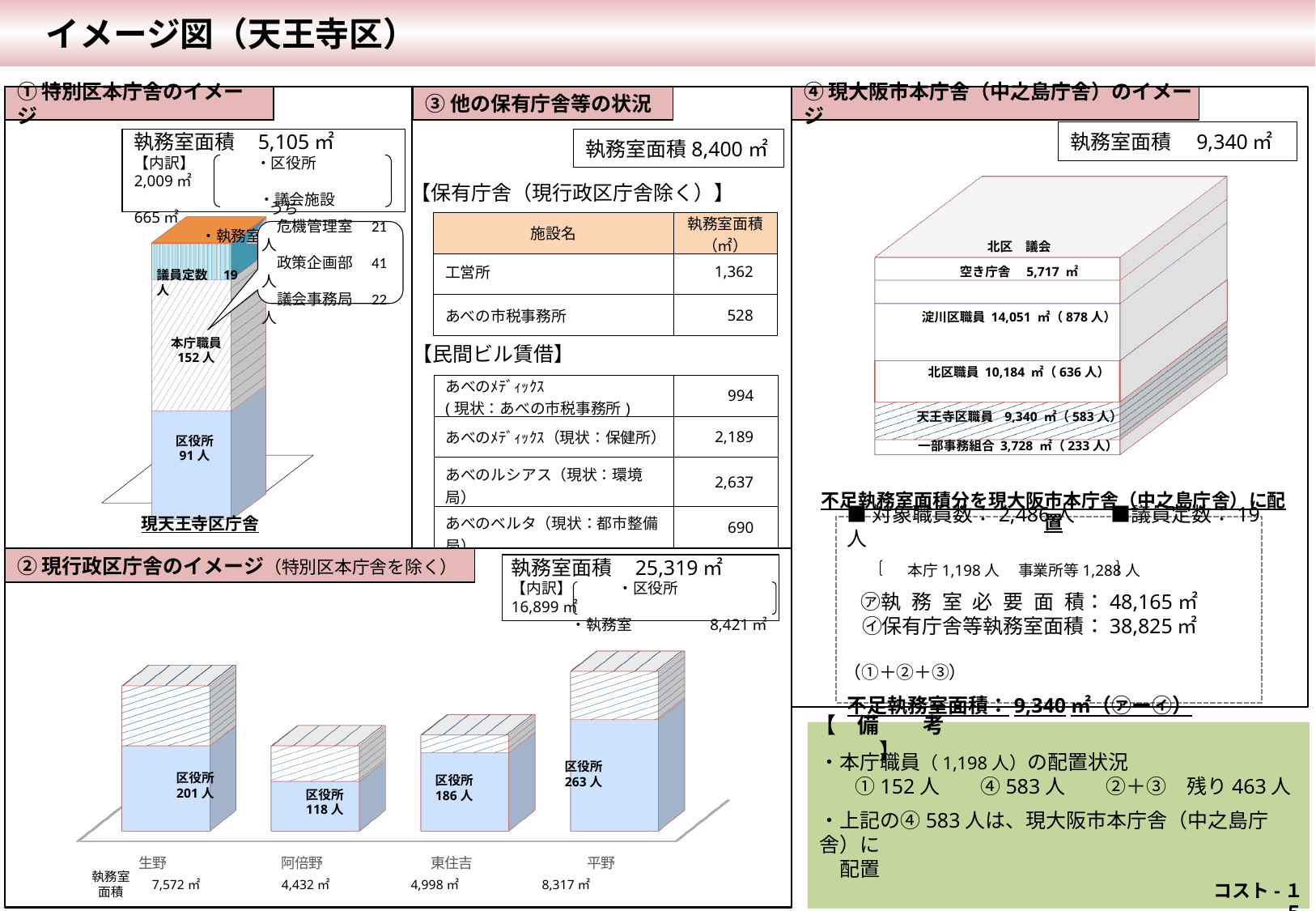
In the ② 現行政区庁舎のイメージ diagram, what is the 執務室面積 for 生野? 7,572 ㎡ In the ④ 現大阪市本庁舎（中之島庁舎）のイメージ stacked diagram, which staff group occupies the largest 執務室面積? 淀川区職員 In the ② 現行政区庁舎のイメージ diagram, which ward has the smallest 区役所 staff count? 阿倍野 In the ① 特別区本庁舎のイメージ stacked block diagram, what is the total of 区役所, 本庁職員 and 議員定数 shown on the block? 262 人 In the ② 現行政区庁舎のイメージ diagram, how many more 区役所 staff does 平野 have than 阿倍野? 145 人 In the ① 特別区本庁舎のイメージ stacked block diagram, how many 本庁職員 are shown? 152 人 In the ④ 現大阪市本庁舎（中之島庁舎）のイメージ stacked diagram, what is the 執務室面積 for 淀川区職員? 14,051 ㎡ In the ② 現行政区庁舎のイメージ diagram at the bottom left, how many wards (区) are shown as blocks? 4 In the ② 現行政区庁舎のイメージ diagram, what is the 区役所 staff count for 東住吉? 186 人 In the ② 現行政区庁舎のイメージ diagram, what is the difference in 執務室面積 between 平野 and 生野? 745 ㎡ In the ② 現行政区庁舎のイメージ diagram, which has the larger 執務室面積, 阿倍野 or 東住吉? 東住吉 In the ② 現行政区庁舎のイメージ diagram, which ward has the largest 区役所 staff count? 平野